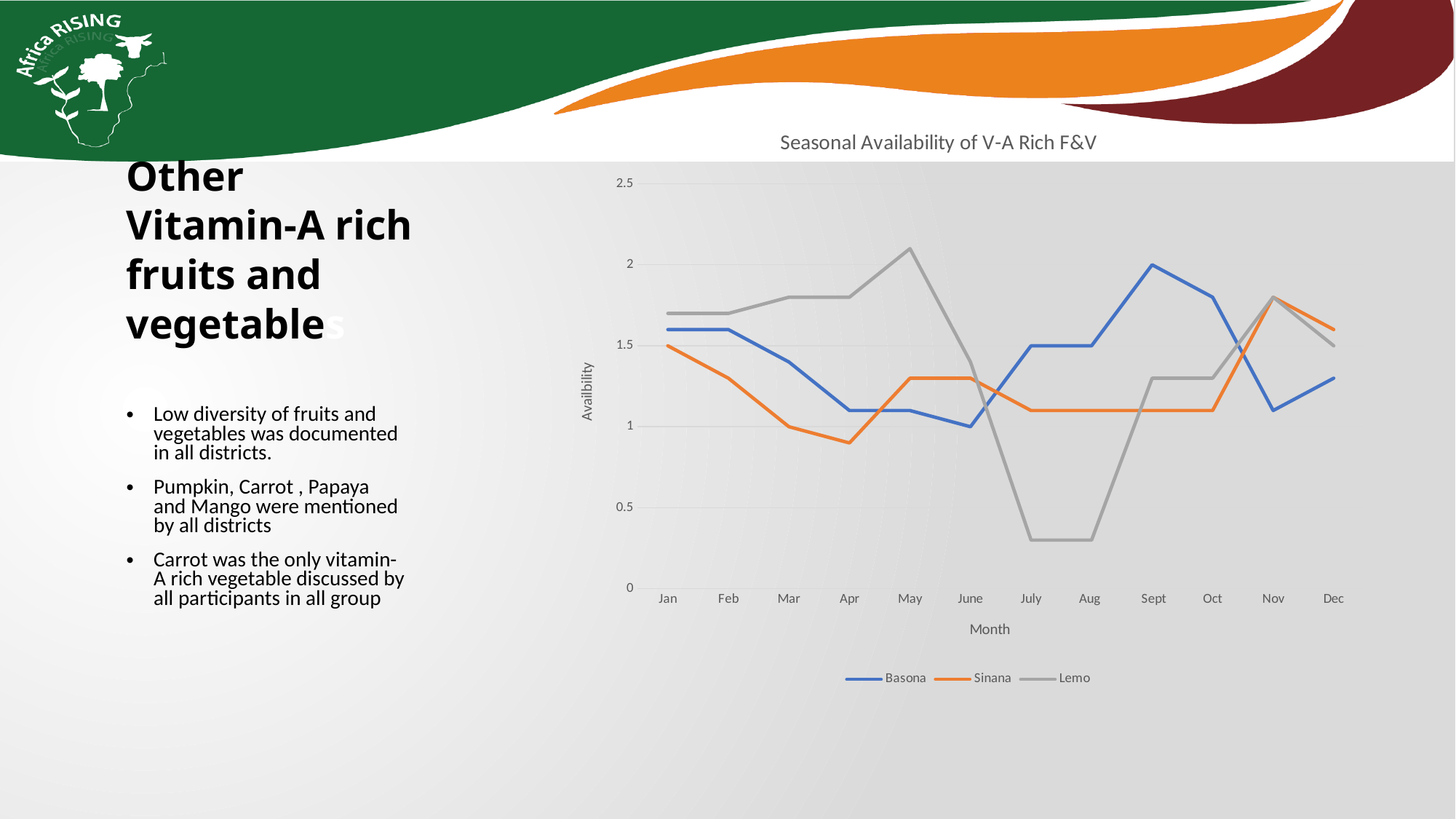
In which month does Sinana reach its lowest value? Apr Is the value for Lemo in July greater or less than 0.5? less What type of chart is shown on the slide? line chart What is the label of the y axis? Availbility In May, which series has the higher value, Lemo or Basona? Lemo Does the Lemo line rise or fall from May to July? fall Is the value for Lemo in May greater or less than 2? greater In which month does Lemo reach its highest value? May How many series does the legend list? 3 In which month does Basona reach its highest value? Sept How many months are plotted along the x axis? 12 What is the title of the chart? Seasonal Availability of V-A Rich F&V